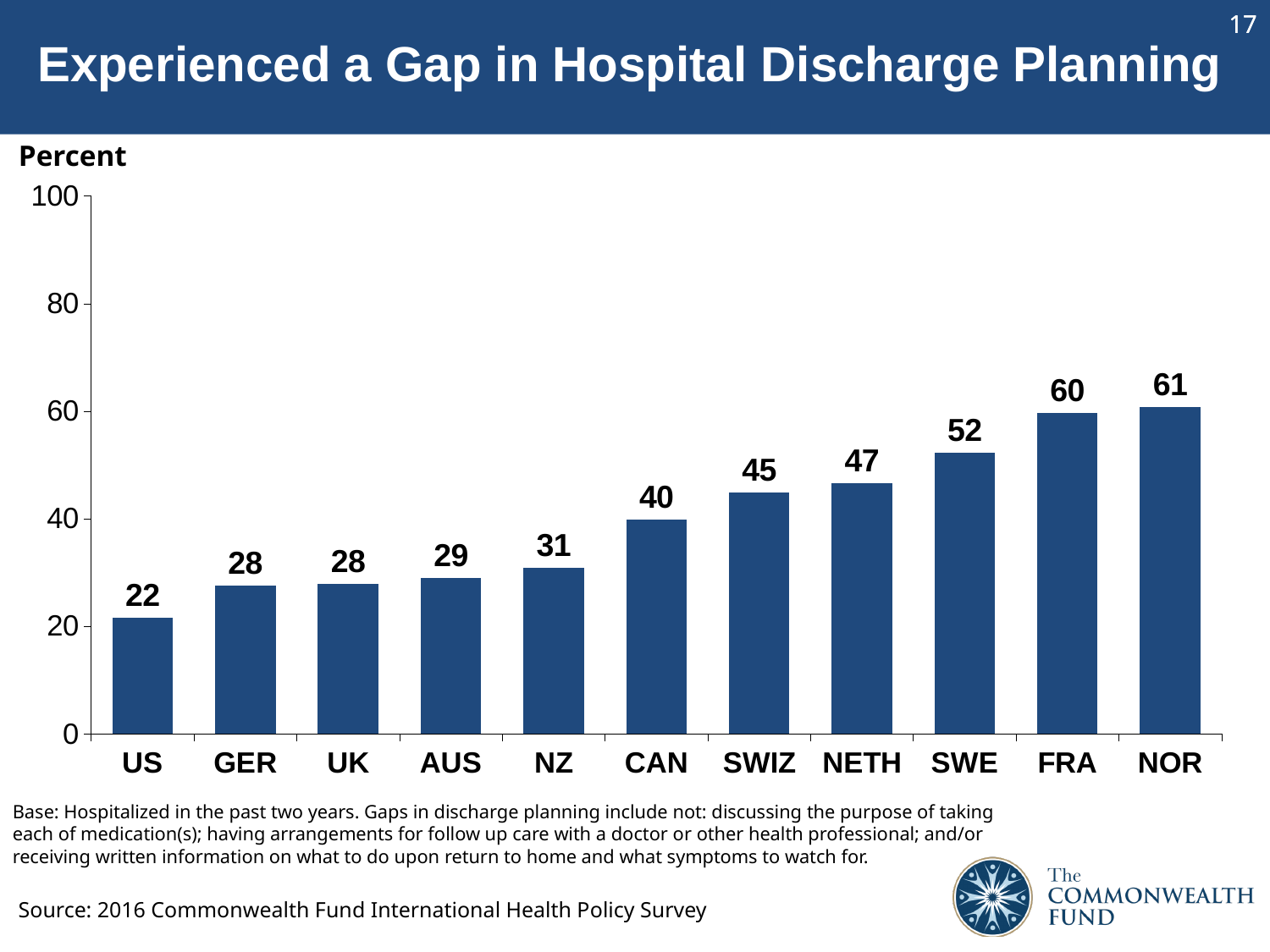
What is the difference between the values for NOR and US? 39 Which country has the lowest value? US Which is larger, the value for NZ or the value for SWIZ? SWIZ What is the value for SWE? 52 Is the value for NETH greater or less than 40? greater What is the difference between the values for FRA and SWE? 8 How many countries are shown on the chart? 11 Do the values rise or fall from left to right along the x axis? rise What is the value for CAN? 40 What is the value for US? 22 Which country has the highest value? NOR What kind of chart is shown on the slide? bar chart